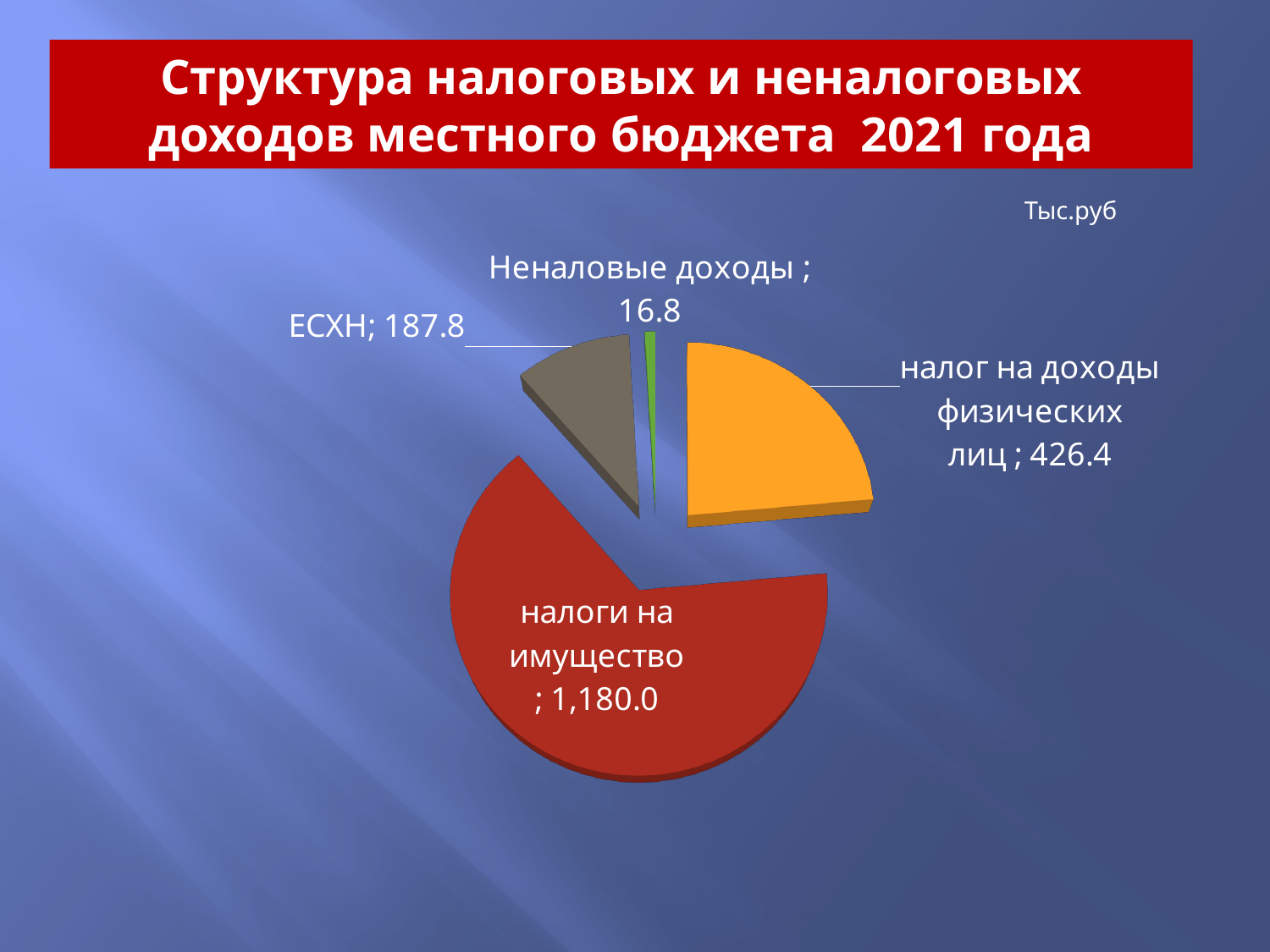
How many slices does the pie chart have? 4 Which category has the largest slice of the pie? налоги на имущество Which is larger, the value for ЕСХН or the value for налог на доходы физических лиц? налог на доходы физических лиц What kind of chart is shown on the slide? Pie chart What is the value for налог на доходы физических лиц? 426.4 What unit of measurement is indicated for the chart values? Тыс.руб What is the value for налоги на имущество? 1,180.0 Which category has the smallest slice of the pie? Неналовые доходы What is the difference between the values for ЕСХН and Неналовые доходы? 171.0 What is the value for ЕСХН? 187.8 What is the value for Неналовые доходы? 16.8 What is the difference between the values for налоги на имущество and налог на доходы физических лиц? 753.6